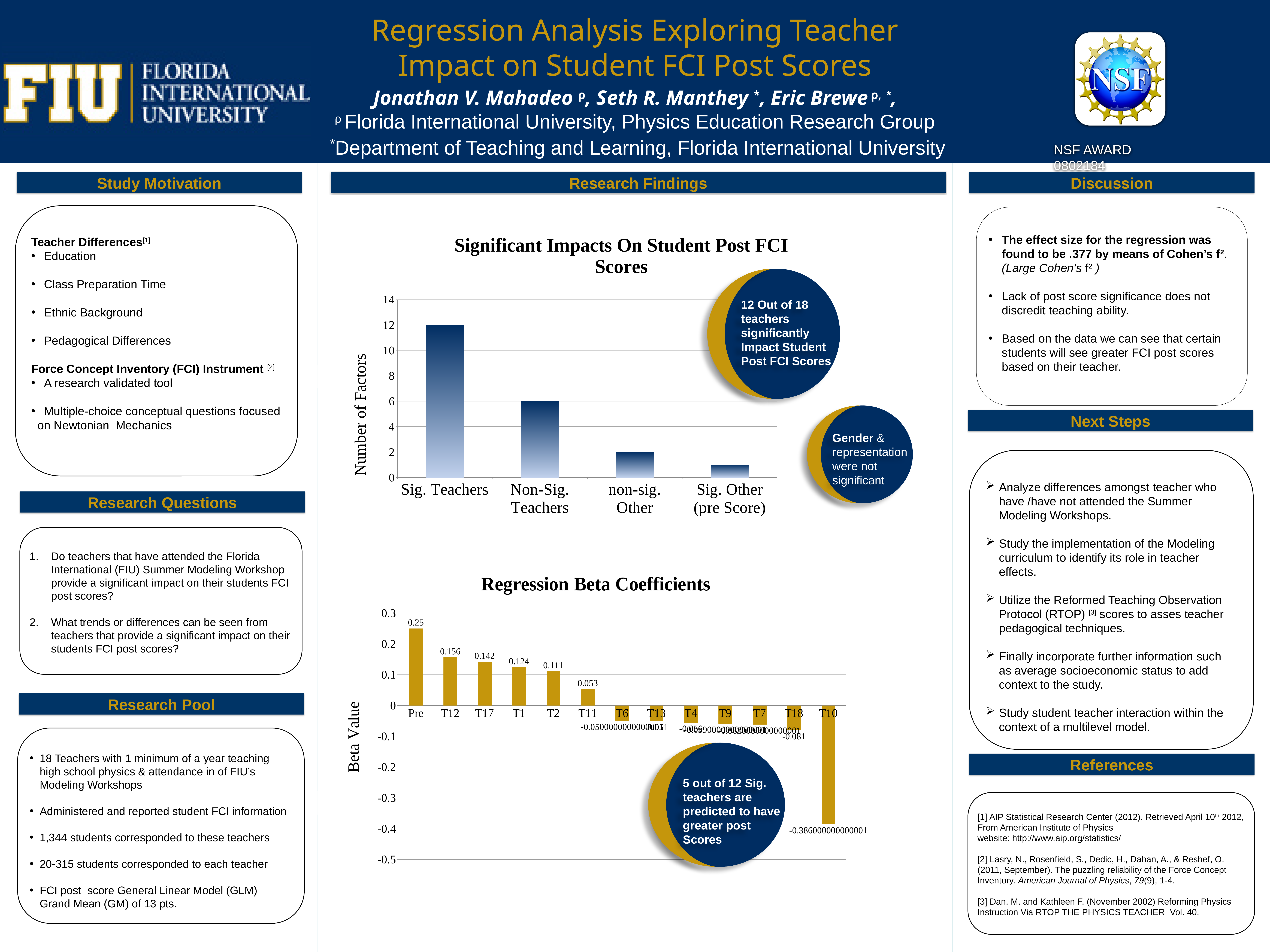
How many categories are shown in the 'Significant Impacts On Student Post FCI Scores' chart? 4 What is the y-axis label of the 'Significant Impacts On Student Post FCI Scores' chart? Number of Factors In the 'Regression Beta Coefficients' chart, what is the beta value for T17? 0.142 In the 'Regression Beta Coefficients' chart, which is larger, the value for T12 or the value for T2? T12 In the 'Regression Beta Coefficients' chart, what is the beta value for Pre? 0.25 In the 'Regression Beta Coefficients' chart, which category has the lowest beta value? T10 What type of chart is the 'Regression Beta Coefficients' chart? Bar chart In the 'Significant Impacts On Student Post FCI Scores' chart, which category has the lowest number of factors? Sig. Other (pre Score) In the 'Significant Impacts On Student Post FCI Scores' chart, what is the value for Sig. Teachers? 12 In the 'Significant Impacts On Student Post FCI Scores' chart, what is the value for Non-Sig. Teachers? 6 In the 'Significant Impacts On Student Post FCI Scores' chart, what is the difference between Sig. Teachers and Non-Sig. Teachers? 6 In the 'Regression Beta Coefficients' chart, what is the difference between the values for T1 and T11? 0.071